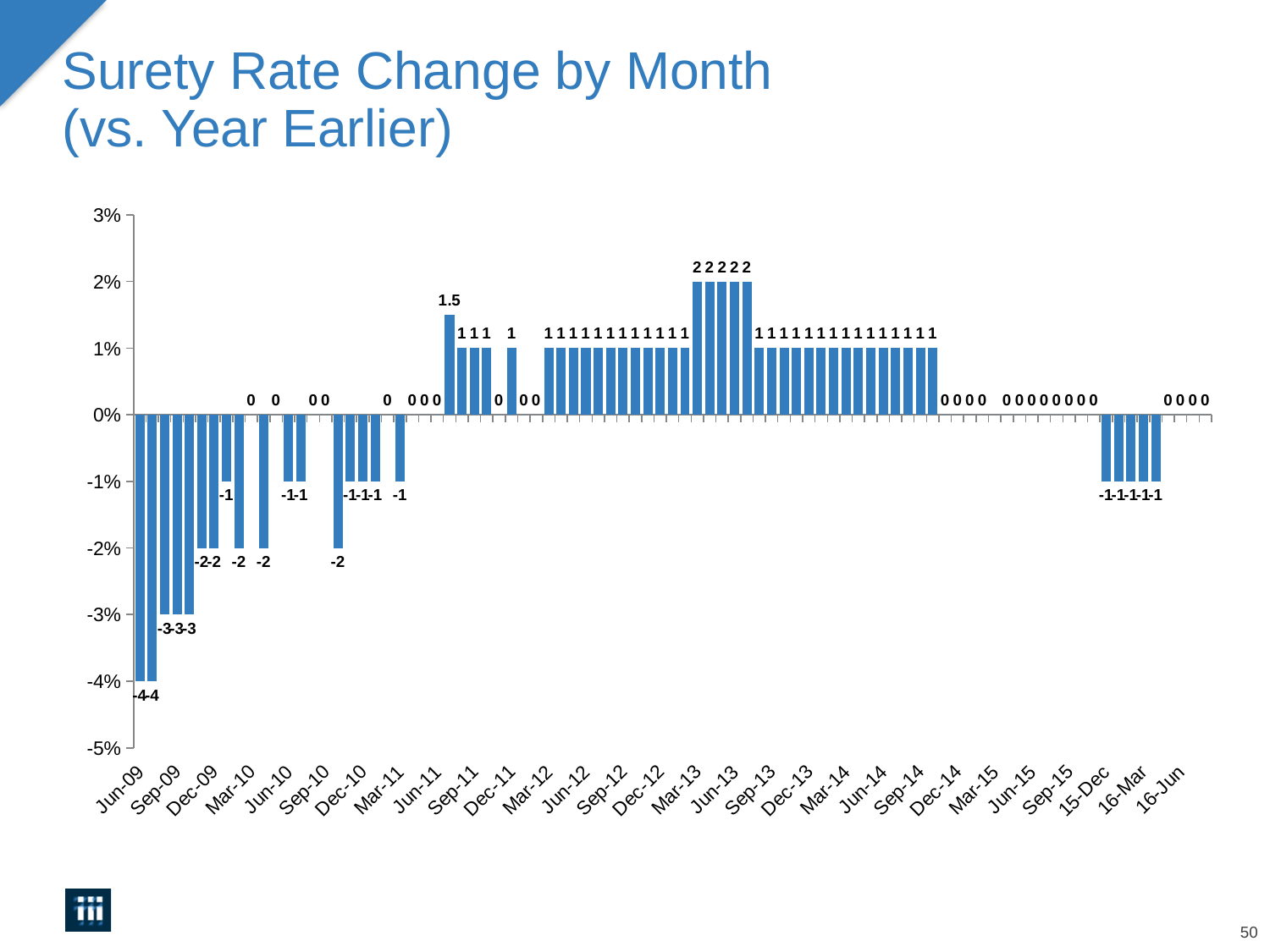
What is the value of the first bar, for Jun-09? -4 What is the lowest data label value shown on the chart? -4 Is the value for Jun-09 greater or less than -3%? less Do the values generally rise or fall from Jun-09 to Sep-11? rise Which has the larger value, the bar for Jun-09 or the bar for Jun-13? Jun-13 How many bars are labeled -4? 2 What type of chart is shown on the slide? bar chart What is the difference between the highest data label (2) and the lowest data label (-4)? 6 How many bars are labeled 2? 5 What is the title of the chart? Surety Rate Change by Month (vs. Year Earlier) What is the value of the tallest bar between the Jun-11 and Sep-11 axis labels? 1.5 What is the highest data label value shown on the chart? 2